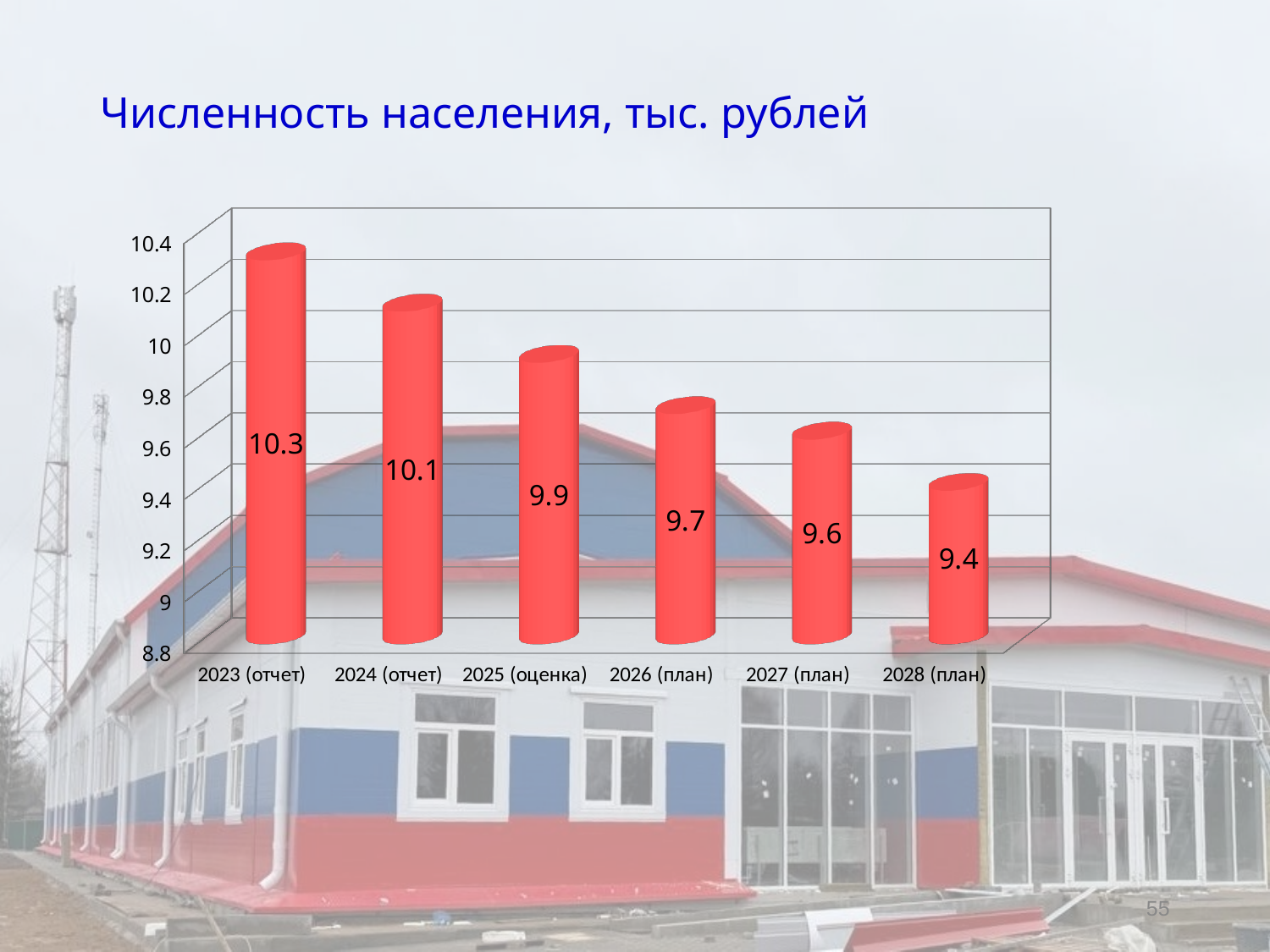
Do the values rise or fall from 2023 (отчет) to 2028 (план)? fall Is the value for 2025 (оценка) greater or less than 10? less What is the value for 2028 (план)? 9.4 What kind of chart is shown on the slide? bar chart What is the difference between the values for 2023 (отчет) and 2028 (план)? 0.9 Which is larger, the value for 2024 (отчет) or the value for 2027 (план)? 2024 (отчет) Which category has the highest value? 2023 (отчет) What is the value for 2026 (план)? 9.7 What is the title of the chart? Численность населения, тыс. рублей Which category has the lowest value? 2028 (план) What is the value for 2023 (отчет)? 10.3 How many categories are shown on the x axis? 6